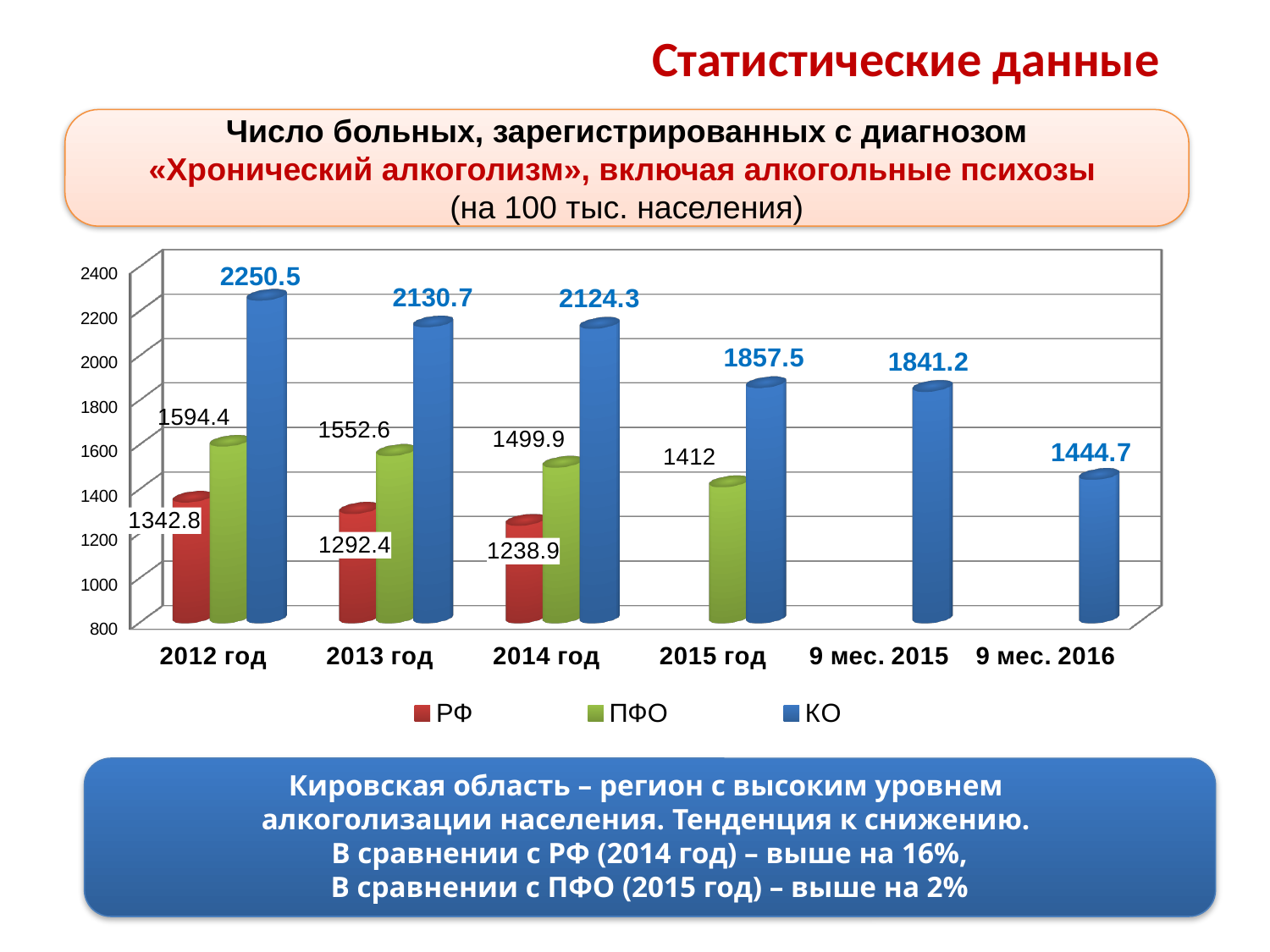
What is the value for ПФО in 2015 год? 1412 In which category is the РФ value lowest? 2014 год What is the value for КО in 9 мес. 2016? 1444.7 What is the value for РФ in 2014 год? 1238.9 How many series does the legend list? 3 What is the difference between the КО values for 2012 год and 2013 год? 119.8 Which is larger in 2013 год: the ПФО value or the РФ value? ПФО What is the value for КО in 2012 год? 2250.5 How many categories are shown on the x axis? 6 What kind of chart is shown on the slide? bar chart In which category is the КО value highest? 2012 год Do the РФ values rise or fall from 2012 год to 2014 год? fall